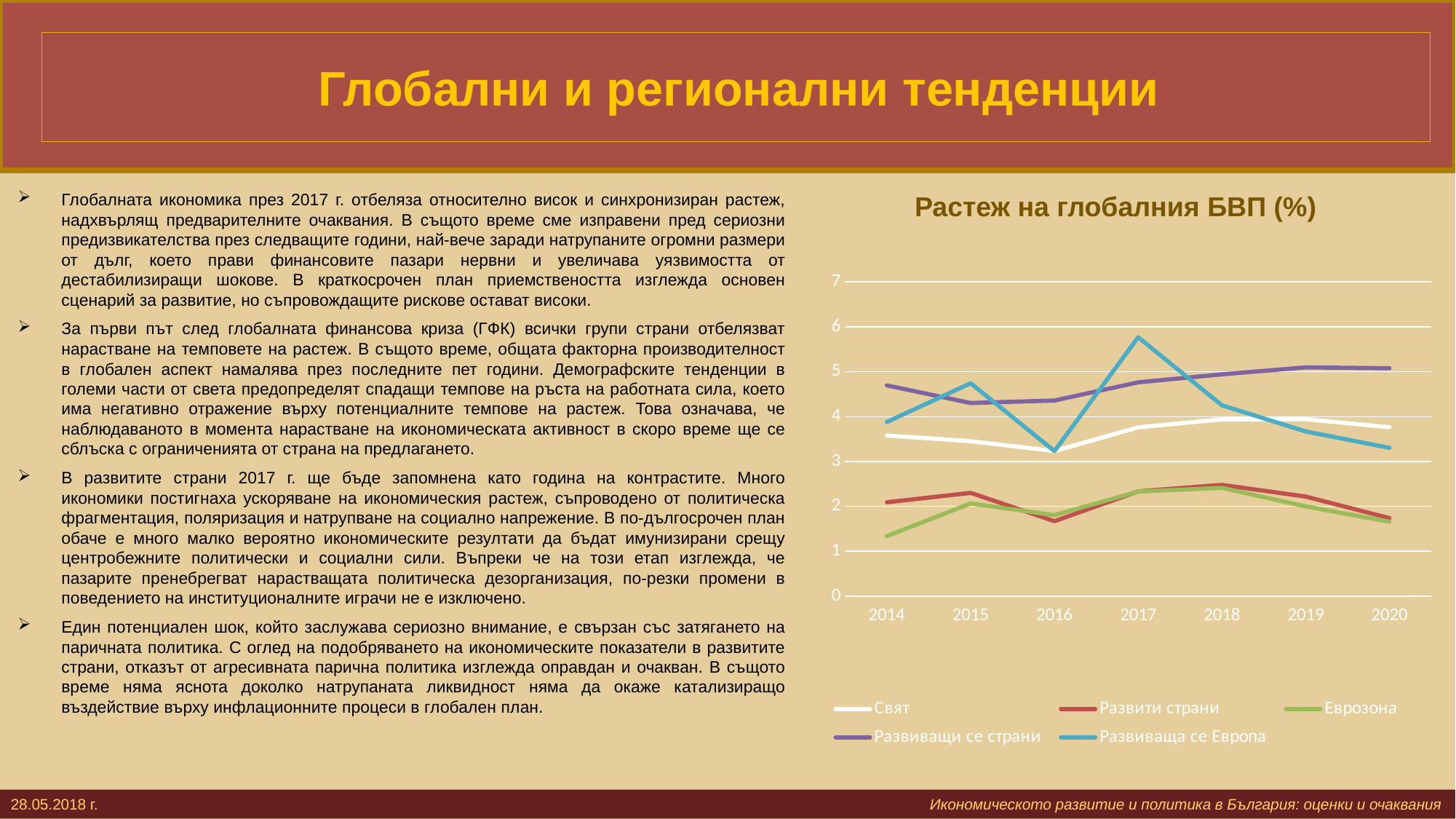
Is the value for Развиваща се Европа in 2017 greater or less than 5? greater What is the title of the chart? Растеж на глобалния БВП (%) Which series has the lowest value in 2014? Еврозона Is the value for Свят in 2016 greater or less than 4? less Does the Развиваща се Европа series rise or fall from 2017 to 2020? fall How many series does the chart legend list? 5 How many years are shown on the x axis of the chart? 7 In which year does the Развиваща се Европа series reach its highest value? 2017 Is the value for Еврозона in 2014 greater or less than 2? less What kind of chart is shown on the slide? line chart In 2014, which is larger: Развити страни or Еврозона? Развити страни Which series has the highest value in 2017? Развиваща се Европа